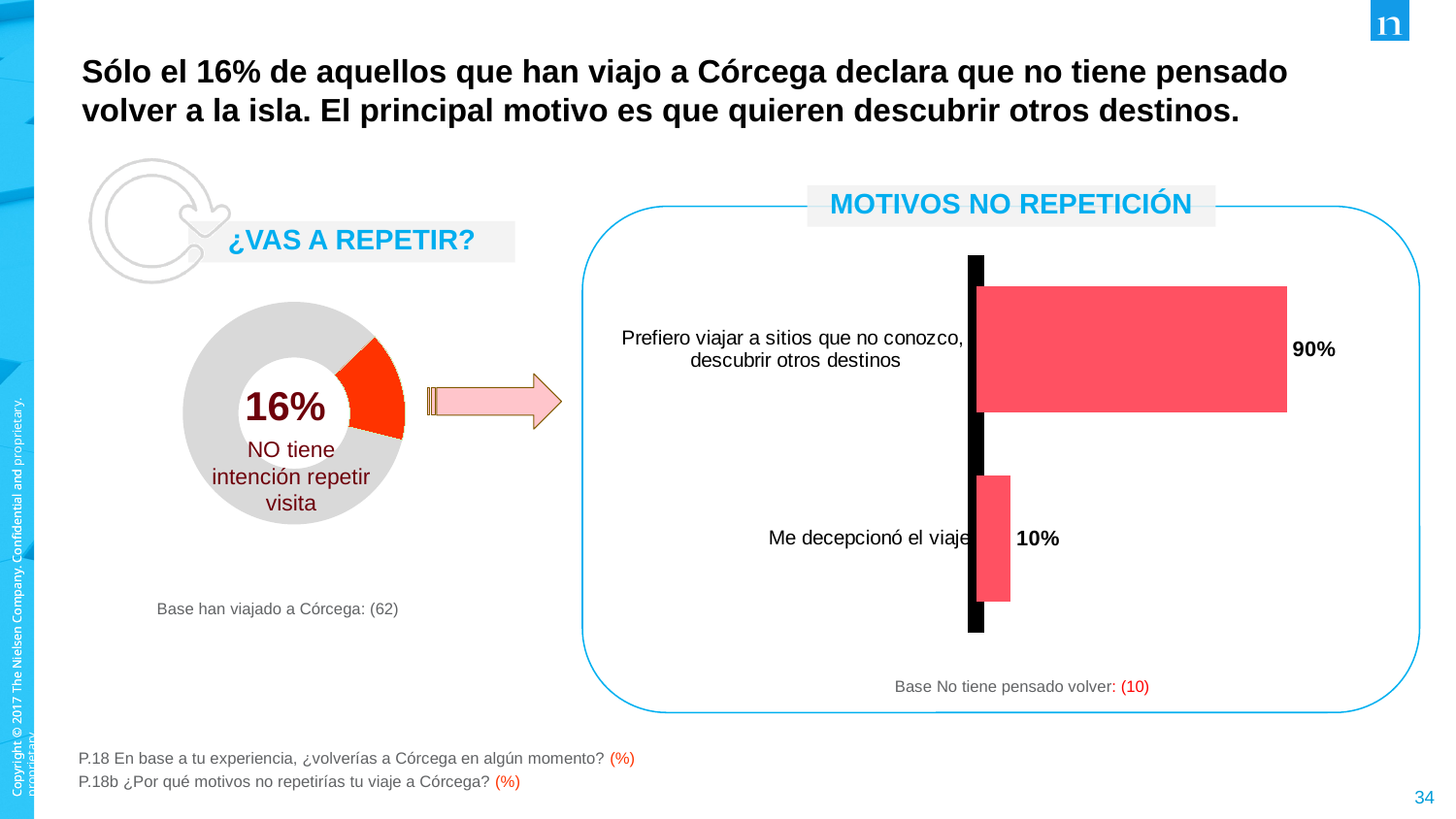
What kind of chart is the 'MOTIVOS NO REPETICIÓN' chart? Bar chart In the 'MOTIVOS NO REPETICIÓN' chart, what is the difference between the values for 'Prefiero viajar a sitios que no conozco, descubrir otros destinos' and 'Me decepcionó el viaje'? 80% How many categories are shown in the 'MOTIVOS NO REPETICIÓN' chart? 2 In the 'MOTIVOS NO REPETICIÓN' chart, what is the value for 'Prefiero viajar a sitios que no conozco, descubrir otros destinos'? 90% What is the base shown for the '¿VAS A REPETIR?' chart? 62 In the 'MOTIVOS NO REPETICIÓN' chart, which category has the highest value? Prefiero viajar a sitios que no conozco, descubrir otros destinos In the 'MOTIVOS NO REPETICIÓN' chart, what is the value for 'Me decepcionó el viaje'? 10% In the 'MOTIVOS NO REPETICIÓN' chart, which category has the lowest value? Me decepcionó el viaje In the 'MOTIVOS NO REPETICIÓN' chart, which is larger: 'Me decepcionó el viaje' or 'Prefiero viajar a sitios que no conozco, descubrir otros destinos'? Prefiero viajar a sitios que no conozco, descubrir otros destinos In the '¿VAS A REPETIR?' chart, what percentage has no intention of repeating the visit? 16% What kind of chart is the '¿VAS A REPETIR?' chart? Donut chart What is the base shown for the 'MOTIVOS NO REPETICIÓN' chart? 10